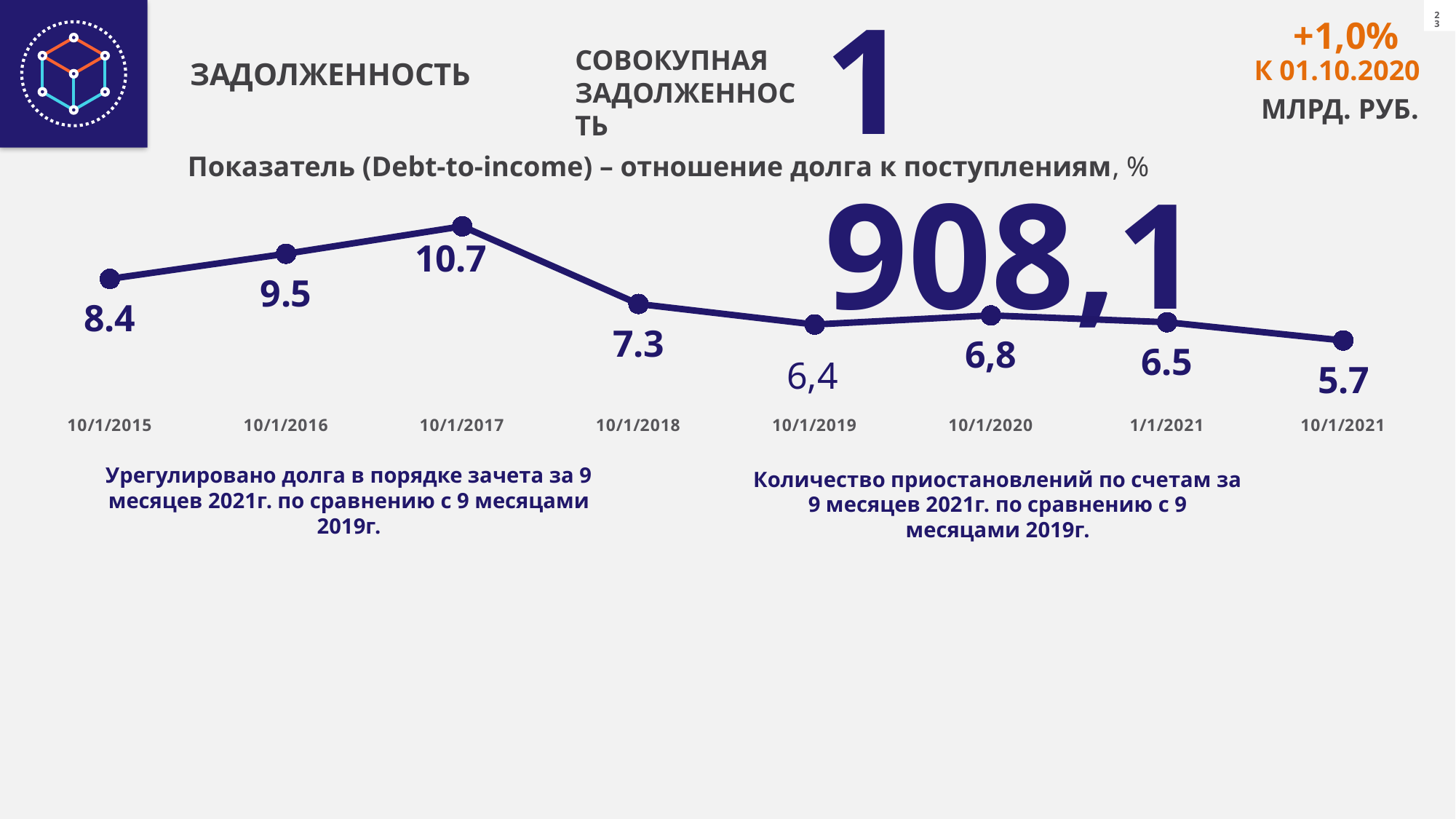
Which is larger, the Debt-to-income value for 10/1/2016 or for 10/1/2018? 10/1/2016 What type of chart is shown on the slide? line chart What is the Debt-to-income value for 10/1/2015? 8.4 Which date has the lowest Debt-to-income value? 10/1/2021 What is the Debt-to-income value for 10/1/2017? 10.7 How many data points are plotted on the line chart? 8 What is the Debt-to-income value for 10/1/2019? 6,4 What is the title of the line chart? Показатель (Debt-to-income) – отношение долга к поступлениям, % What is the difference between the Debt-to-income values for 10/1/2017 and 10/1/2018? 3.4 Which date has the highest Debt-to-income value? 10/1/2017 What is the Debt-to-income value for 10/1/2021? 5.7 Does the Debt-to-income value rise or fall from 10/1/2017 to 10/1/2021? fall